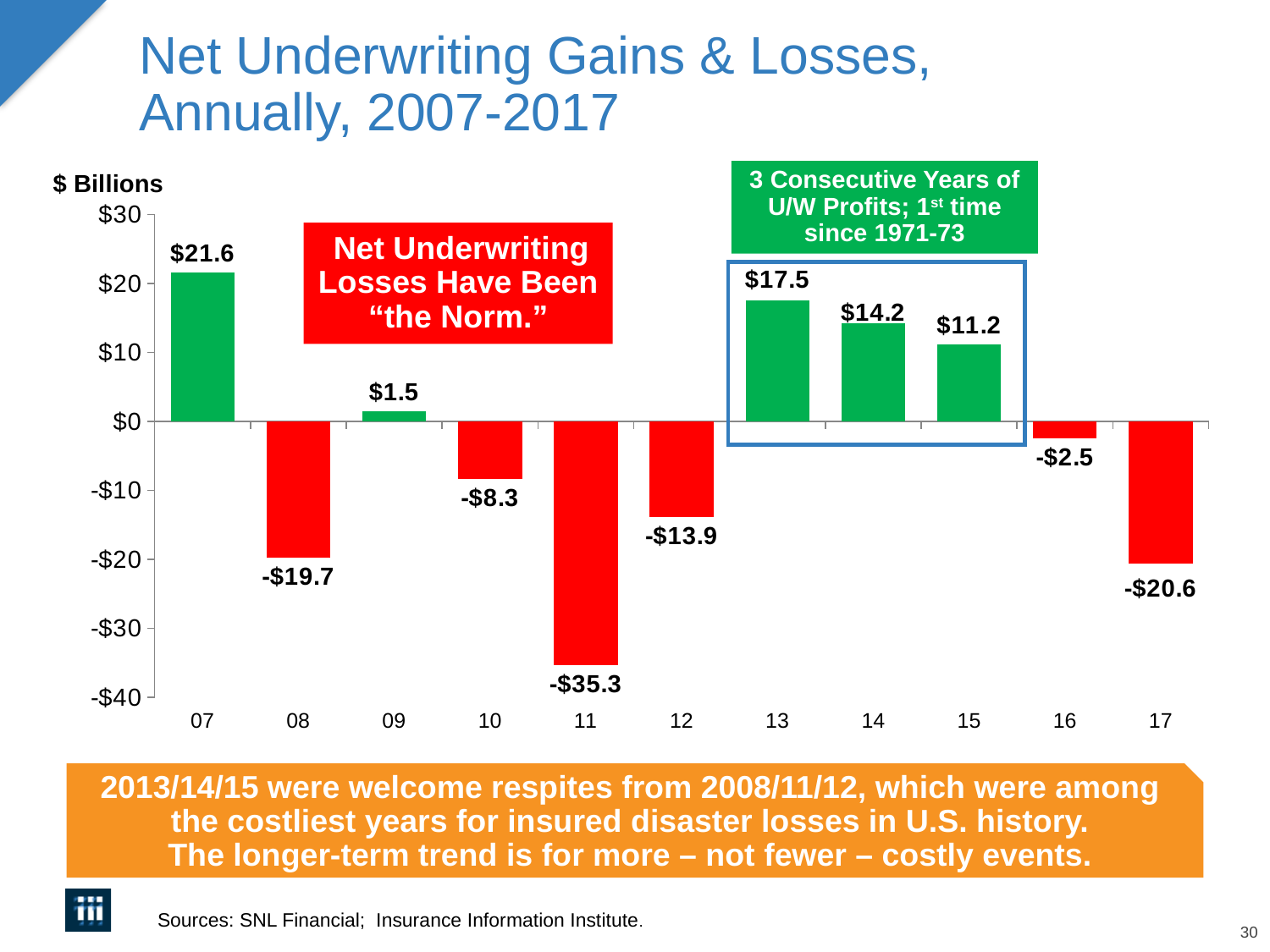
Do the values fall or rise from 2013 to 2015? Fall What is the difference between the values for 2013 and 2015? $6.3 Which year has the largest net underwriting loss? 11 What is the value shown for 2007? $21.6 What is the value shown for 2016? -$2.5 What unit is shown above the y axis? $ Billions What kind of chart is shown on the slide? Bar chart Which year has the highest net underwriting gain? 07 What colour are the bars for years with net underwriting losses? Red Which year has the larger value, 2014 or 2015? 14 What is the net underwriting gain or loss for 2011? -$35.3 How many years are shown on the x axis? 11